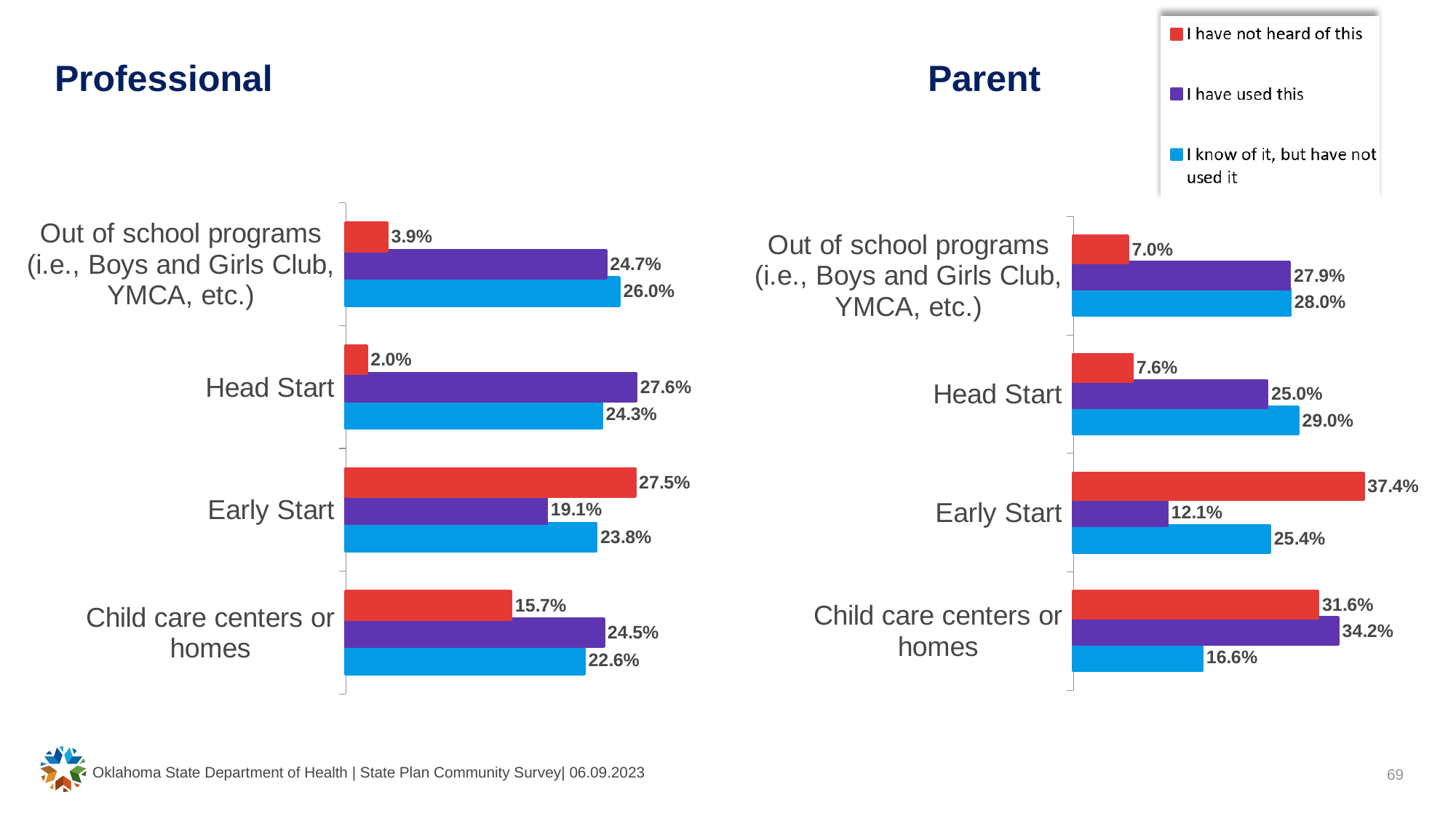
In the Parent chart, what is the difference between 'I have not heard of this' and 'I have used this' for Early Start? 25.3% In the Parent chart, what is the value for 'I have not heard of this' for Early Start? 37.4% In the Parent chart, what is the value for 'I know of it, but have not used it' for Child care centers or homes? 16.6% How many series does the legend list? 3 How many categories are shown in the Parent chart? 4 In the Professional chart, what is the value for 'I have used this' for Head Start? 27.6% In the Professional chart, which is larger for Early Start: 'I have used this' or 'I know of it, but have not used it'? I know of it, but have not used it In the Professional chart, which category has the lowest value for 'I have not heard of this'? Head Start In the Parent chart, which category has the highest value for 'I have used this'? Child care centers or homes What kind of chart is the Professional chart? Bar chart Which colour represents 'I have used this' in the legend? Purple In the Professional chart, which category has the highest value for 'I have not heard of this'? Early Start